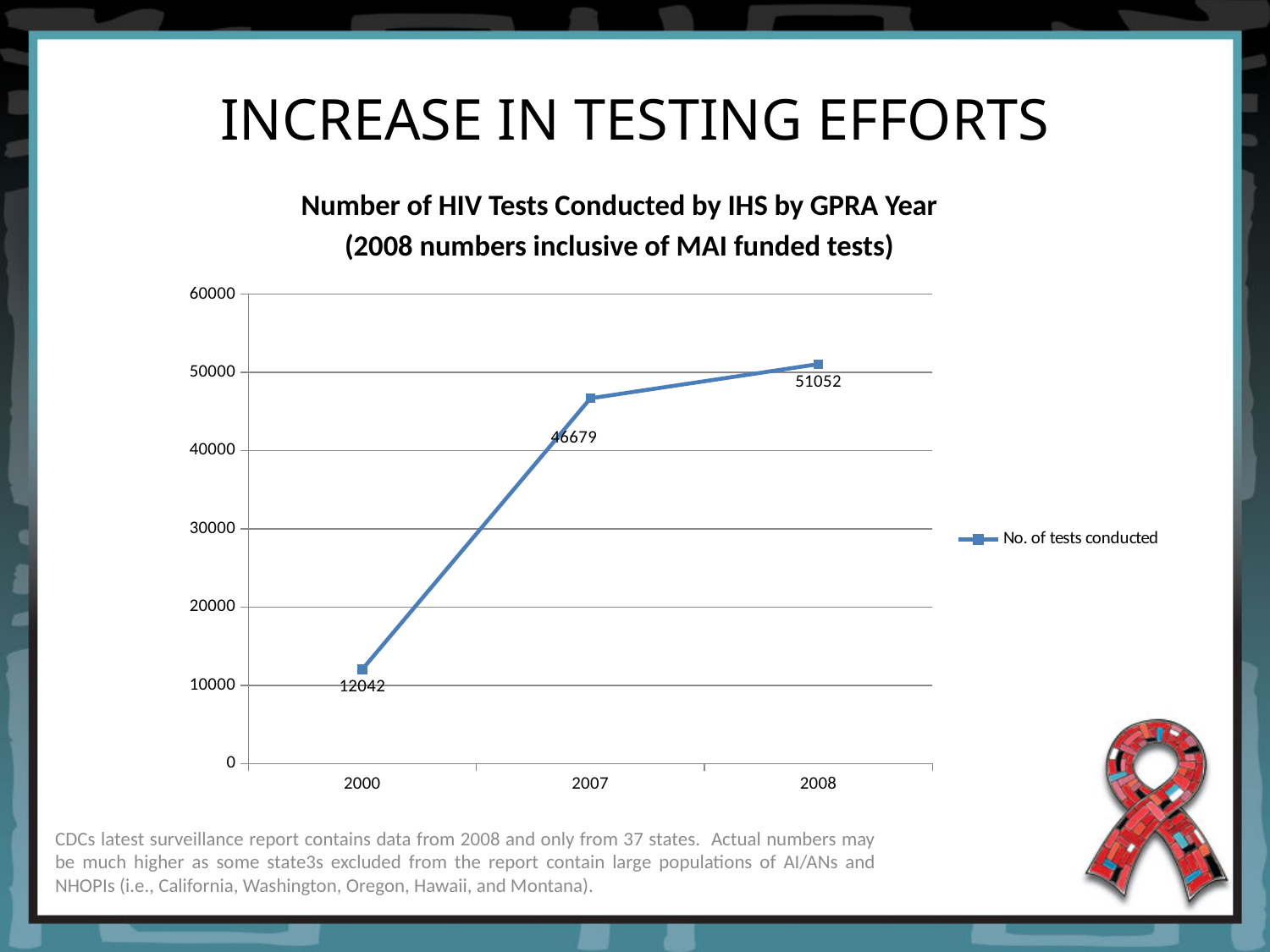
What is the number of tests conducted in 2007? 46679 What is the number of tests conducted in 2008? 51052 What kind of chart is shown on the slide? line chart Which year had more tests conducted, 2000 or 2007? 2007 What is the difference in the number of tests conducted between 2007 and 2000? 34637 Which year has the lowest number of tests conducted? 2000 What is the number of tests conducted in 2000? 12042 How many years are plotted on the x axis? 3 Which year has the highest number of tests conducted? 2008 Is the value for 2008 greater or less than 50000? greater What is the difference in the number of tests conducted between 2008 and 2007? 4373 Do the values rise or fall from 2000 to 2008? rise